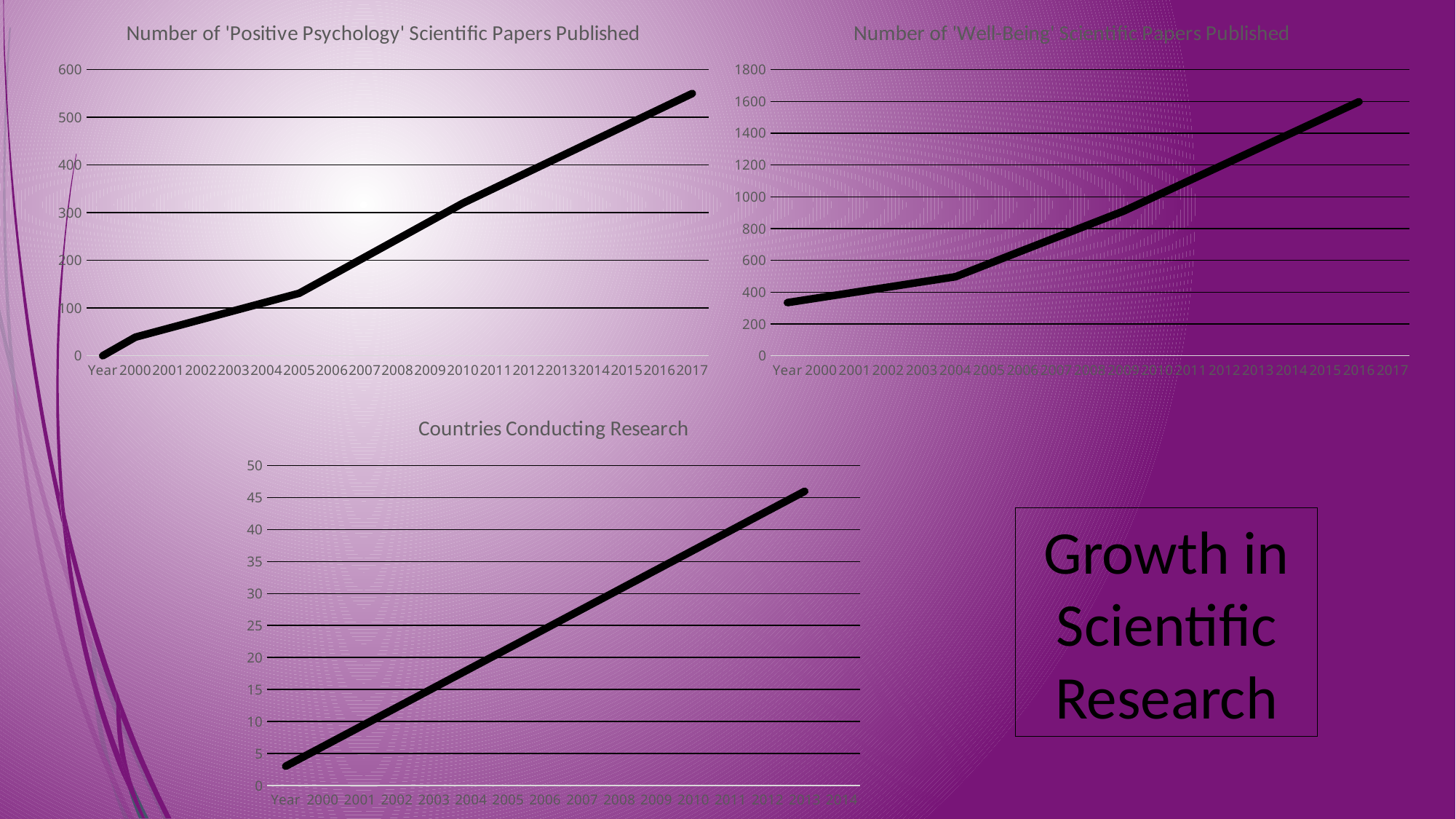
In the 'Number of 'Positive Psychology' Scientific Papers Published' chart, do the values rise or fall from 2000 to 2017? Rise What kind of chart is 'Number of 'Positive Psychology' Scientific Papers Published'? Line chart How many charts are shown on the slide? 3 What is the title of the chart at the top right of the slide? Number of 'Well-Being' Scientific Papers Published In the 'Number of 'Positive Psychology' Scientific Papers Published' chart, is the value for 2005 greater or less than 200? less What kind of chart is 'Countries Conducting Research'? Line chart In the 'Number of 'Well-Being' Scientific Papers Published' chart, do the values rise or fall over the years shown? Rise In the 'Number of 'Positive Psychology' Scientific Papers Published' chart, is the value for 2017 greater or less than 500? greater